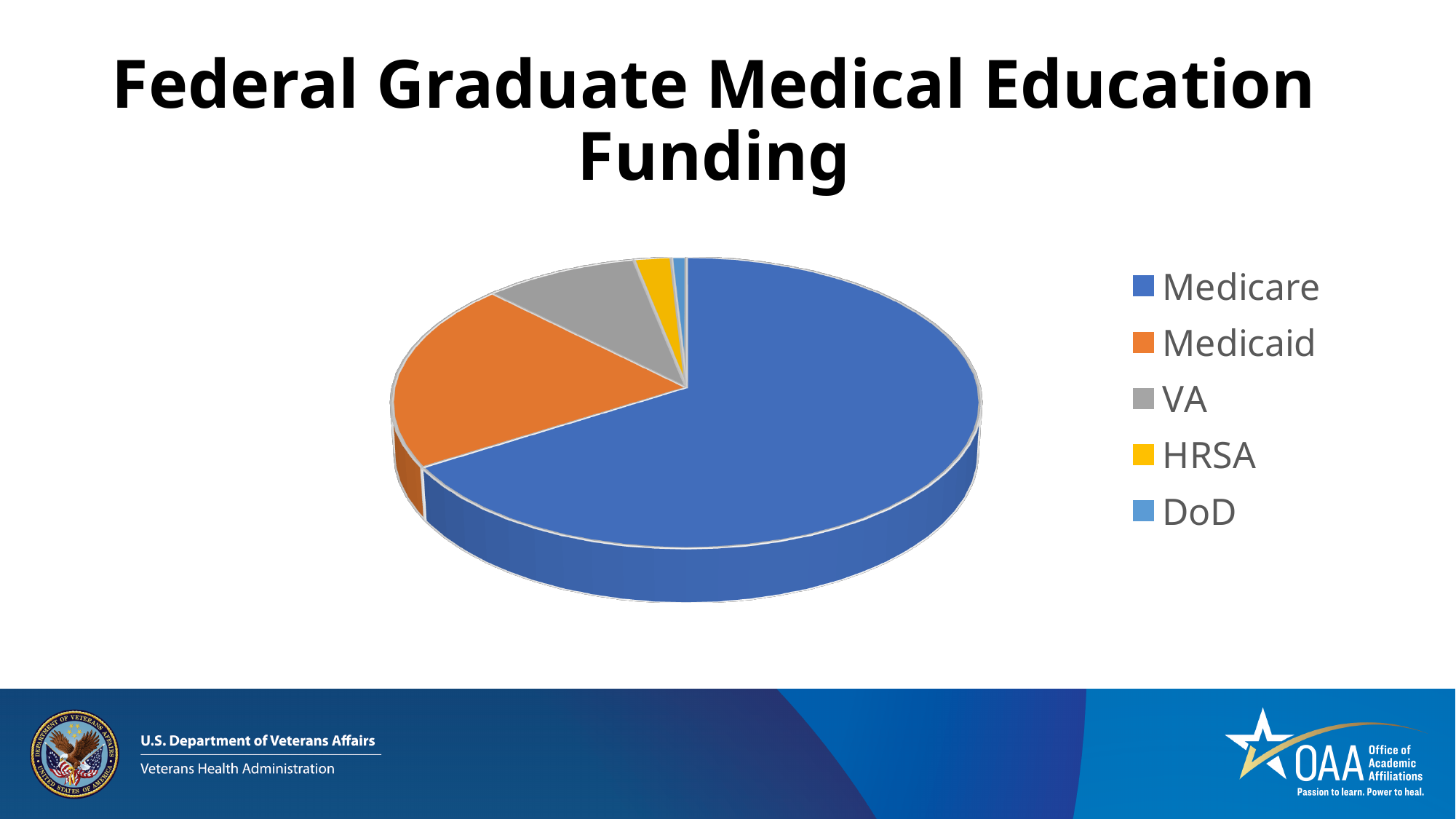
What is the title of the slide containing the pie chart? Federal Graduate Medical Education Funding Which funding source has the smallest slice of the pie? DoD Which funding source has the second-largest slice of the pie? Medicaid Which slice is larger, VA or HRSA? VA What kind of chart is shown on the slide? Pie chart How many entries does the legend list? 5 What colour is the VA slice in the pie chart? Grey How many slices does the pie chart have? 5 Which slice is larger, Medicaid or VA? Medicaid Which funding source has the largest slice of the pie? Medicare Which slice is larger, Medicare or Medicaid? Medicare